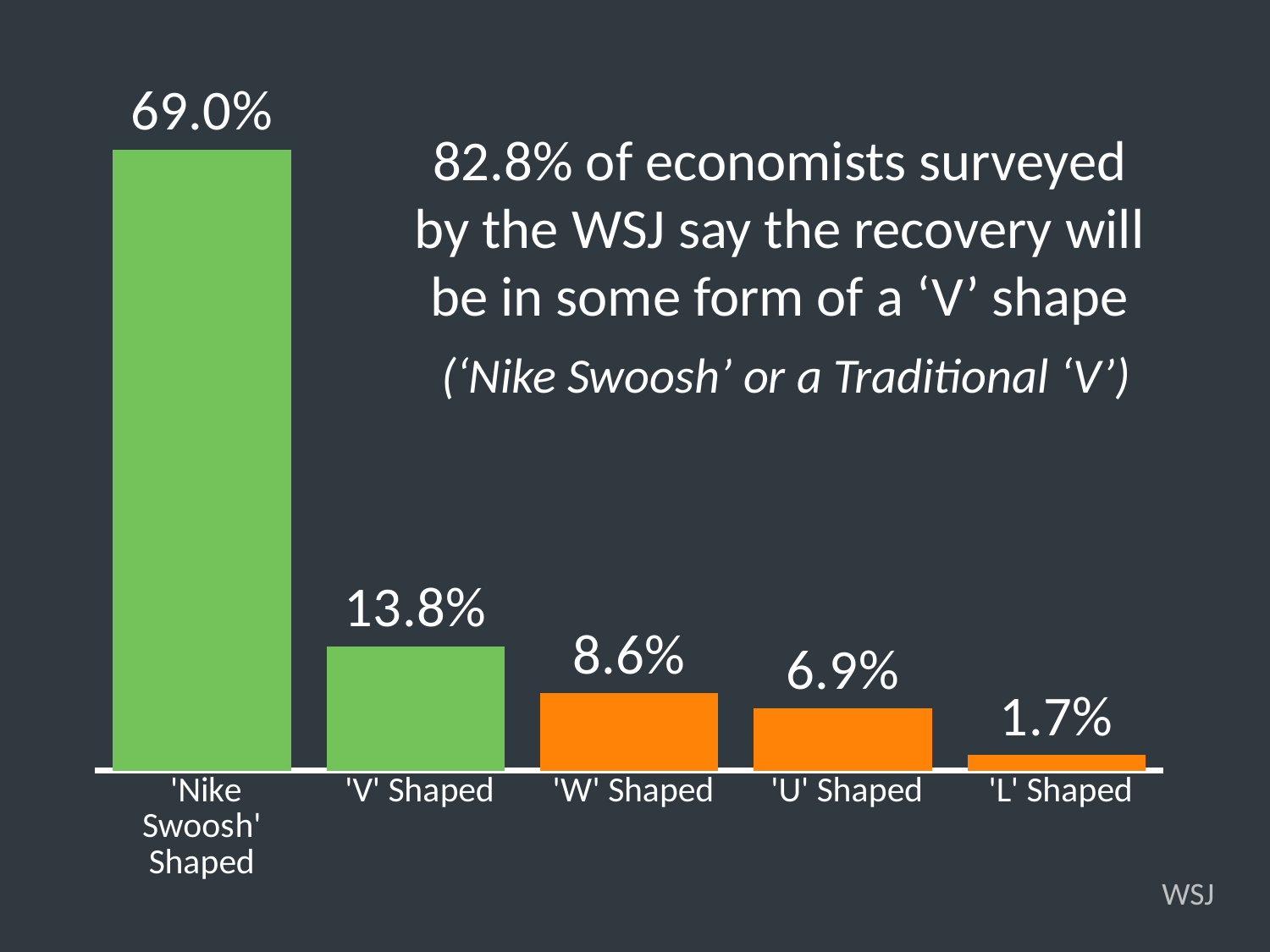
What is the value shown for 'L' Shaped? 1.7% What is the difference between the 'Nike Swoosh' Shaped and 'V' Shaped values? 55.2% How many recovery shape categories are shown in the chart? 5 What percentage of economists expect a 'Nike Swoosh' shaped recovery? 69.0% What is the difference between the 'W' Shaped and 'U' Shaped values? 1.7% Do the values rise or fall moving from left to right across the categories? Fall What kind of chart is shown on the slide? Bar chart Which recovery shape has the highest percentage? 'Nike Swoosh' Shaped Which recovery shape has the lowest percentage? 'L' Shaped What colour are the bars for 'Nike Swoosh' Shaped and 'V' Shaped? Green Which is larger, the value for 'U' Shaped or 'L' Shaped? 'U' Shaped What is the value shown for 'W' Shaped? 8.6%